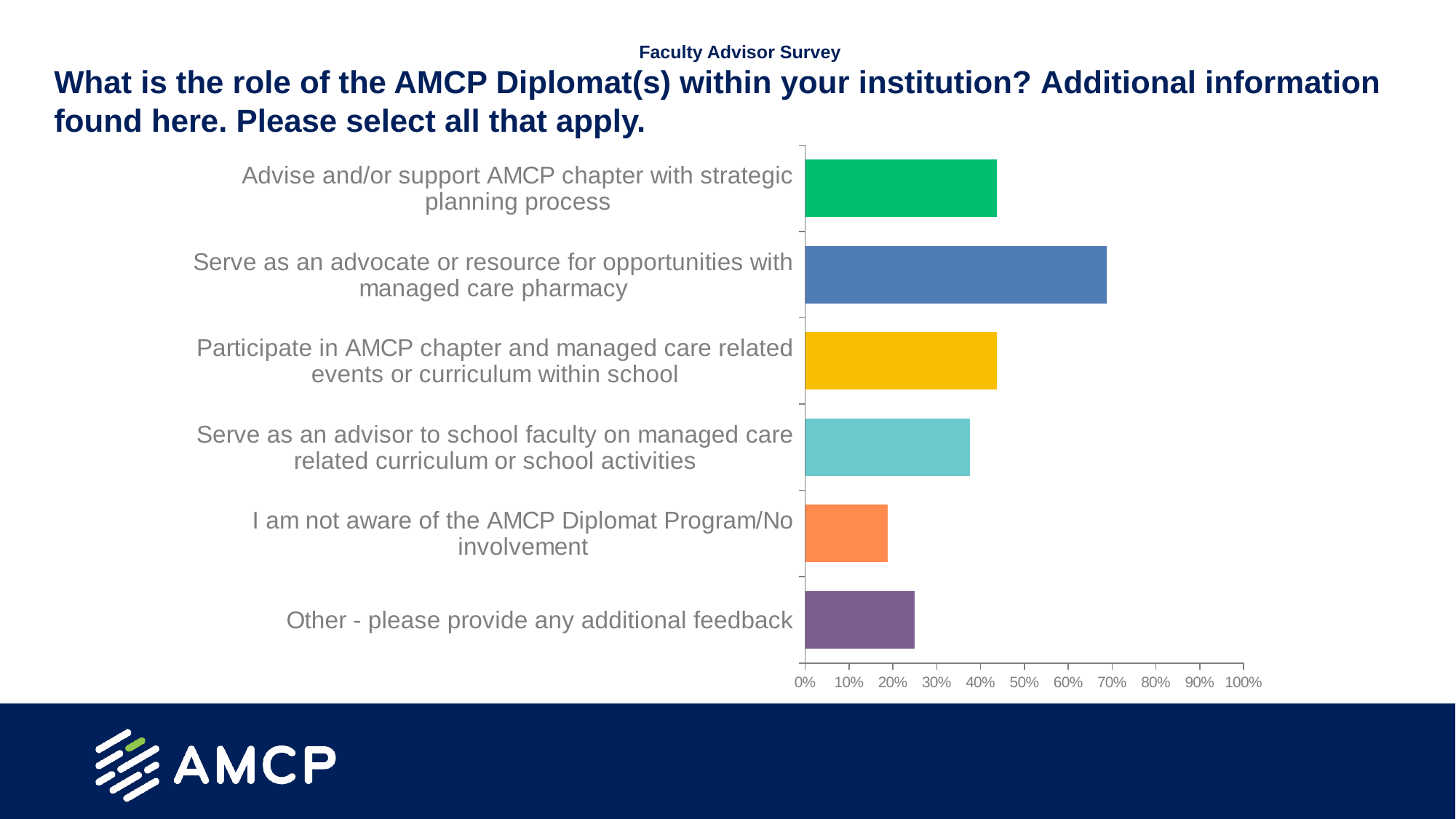
How many categories (response options) are shown in the chart? 6 Is the value for "Serve as an advisor to school faculty on managed care related curriculum or school activities" greater or less than 30%? greater Which response option has the lowest value? I am not aware of the AMCP Diplomat Program/No involvement What is the maximum value shown on the horizontal axis of the chart? 100% Which is larger: the value for "Serve as an advisor to school faculty on managed care related curriculum or school activities" or the value for "Other - please provide any additional feedback"? Serve as an advisor to school faculty on managed care related curriculum or school activities Is the value for "Advise and/or support AMCP chapter with strategic planning process" greater or less than 50%? less Which is larger: the value for "Serve as an advocate or resource for opportunities with managed care pharmacy" or the value for "Advise and/or support AMCP chapter with strategic planning process"? Serve as an advocate or resource for opportunities with managed care pharmacy Is the value for "Serve as an advocate or resource for opportunities with managed care pharmacy" greater or less than 60%? greater Which response option has the highest value? Serve as an advocate or resource for opportunities with managed care pharmacy What kind of chart is shown on the slide? bar chart